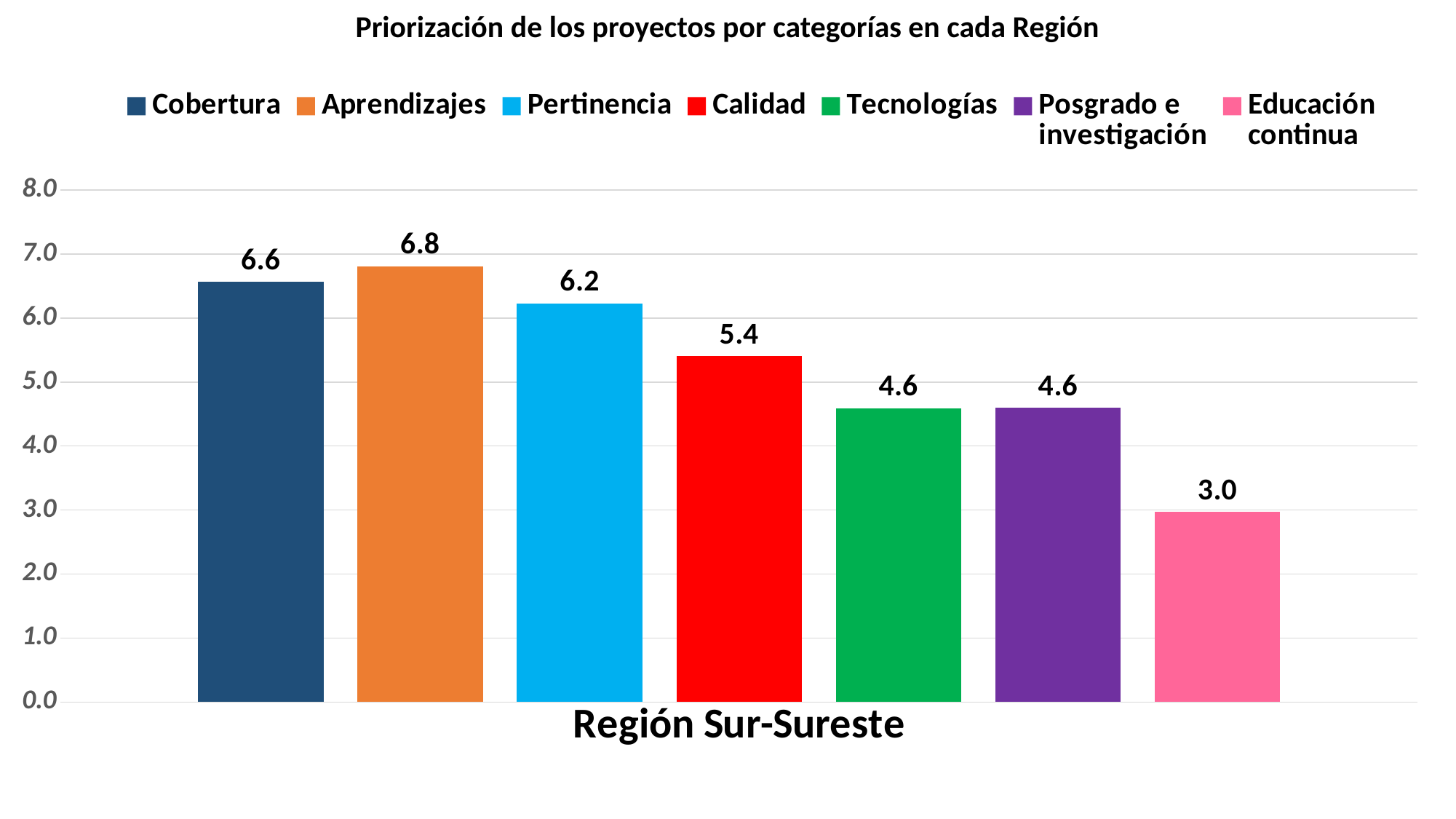
Which series has the highest value? Aprendizajes How many series does the legend list? 7 What is the value for Aprendizajes in Región Sur-Sureste? 6.8 What is the value for Educación continua? 3.0 Is the value for Pertinencia greater or less than 6.0? greater What is the difference between Cobertura and Pertinencia? 0.4 What is the difference between Aprendizajes and Educación continua? 3.8 What is the value for Calidad? 5.4 What is the title of the chart? Priorización de los proyectos por categorías en cada Región What kind of chart is this? bar chart Which series has the lowest value? Educación continua Which is larger, Calidad or Tecnologías? Calidad